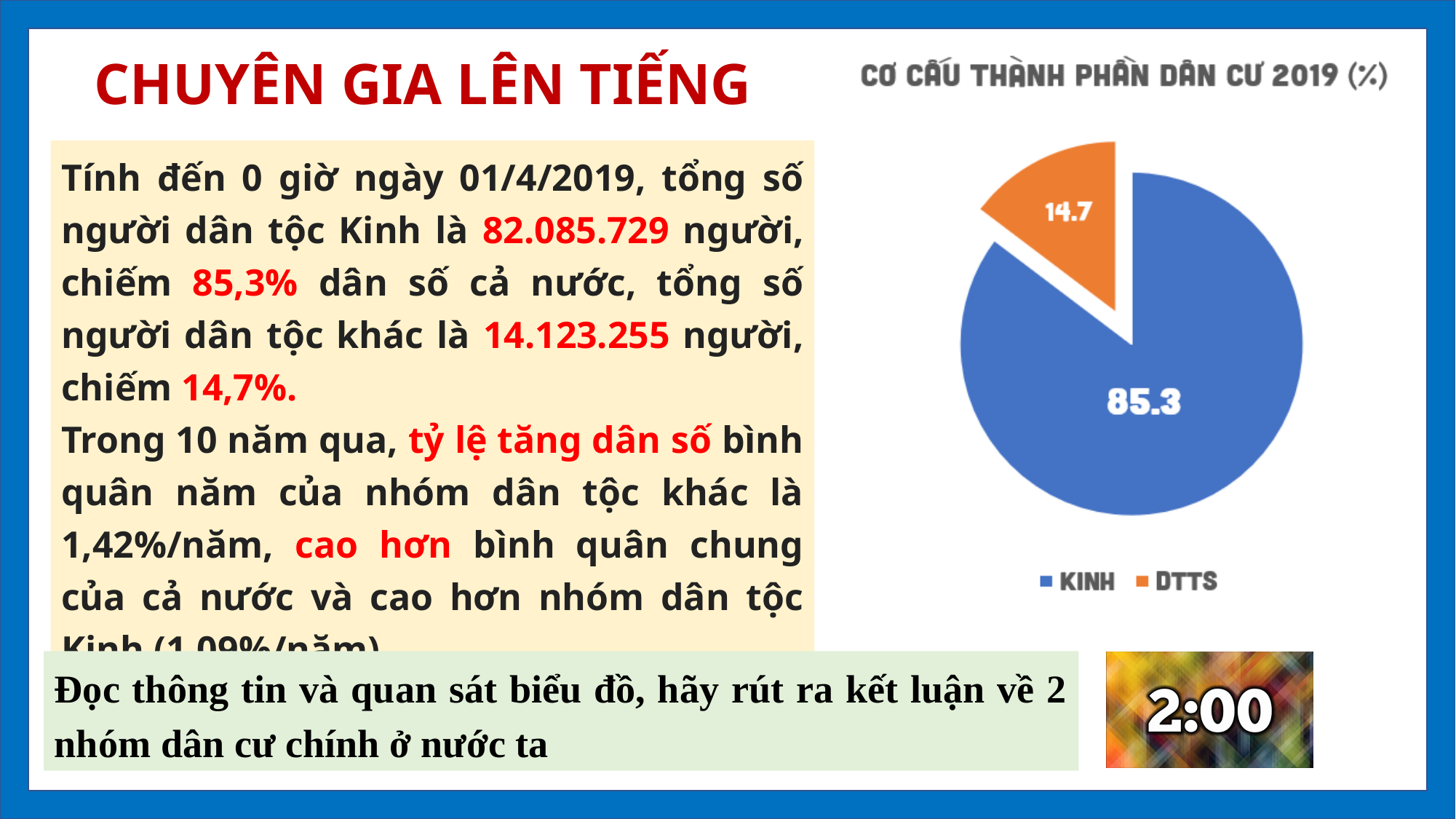
Which category has the largest slice in the pie chart? KINH What share of the pie does the KINH slice represent? 85.3% How many entries does the chart legend list? 2 How many slices does the pie chart have? 2 What is the value shown for DTTS in the pie chart? 14.7 Which is larger in the pie chart, KINH or DTTS? KINH What kind of chart is shown on the slide? pie chart What is the value shown for KINH in the pie chart? 85.3 What is the title of the chart? CƠ CẤU THÀNH PHẦN DÂN CƯ 2019 (%) Which category has the smallest slice in the pie chart? DTTS What colour is the DTTS slice in the pie chart? orange What is the difference between the KINH and DTTS values in the pie chart? 70.6